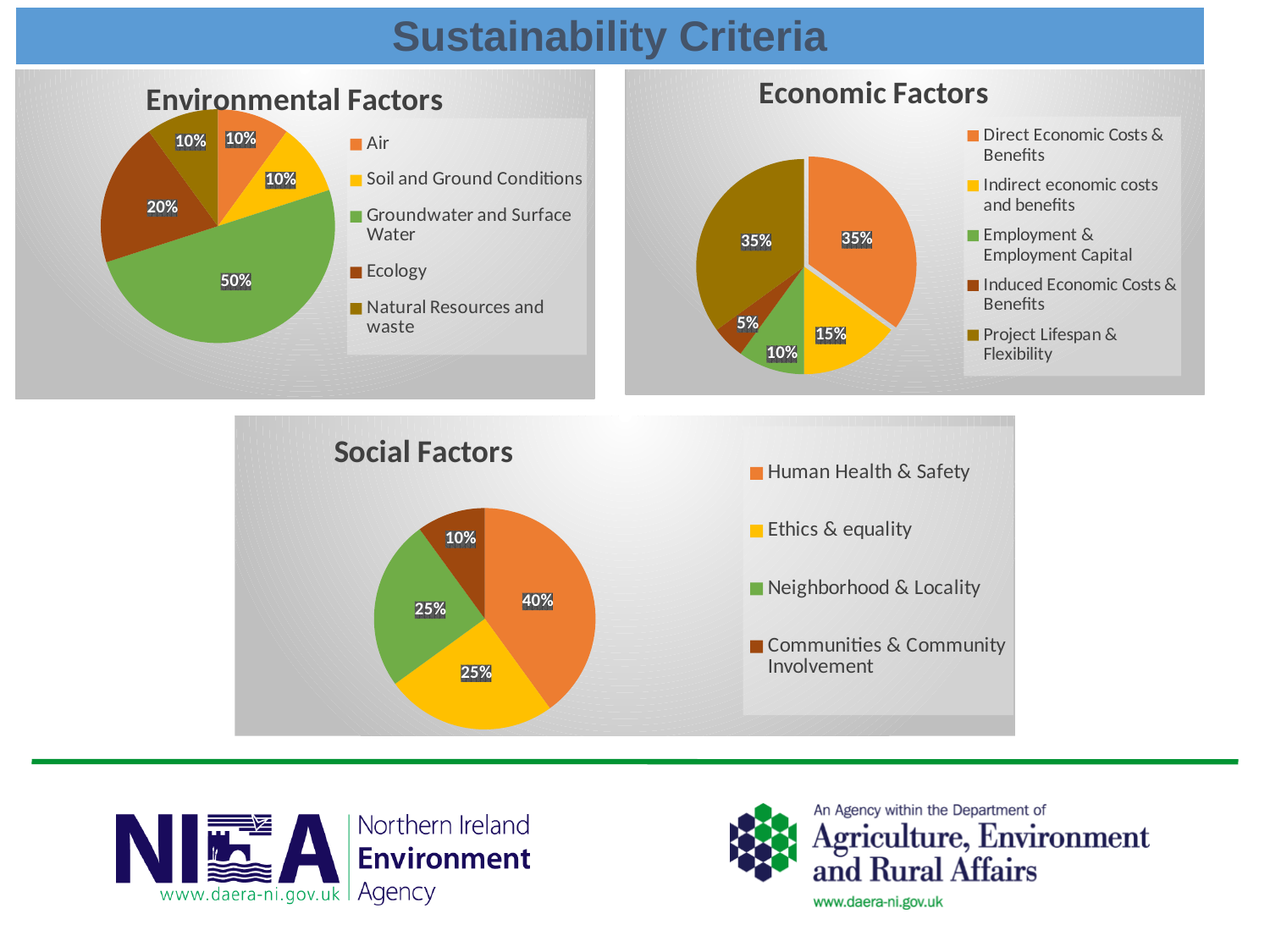
In the Environmental Factors chart, which category has the largest slice? Groundwater and Surface Water In the Economic Factors chart, which is larger: Indirect economic costs and benefits or Employment & Employment Capital? Indirect economic costs and benefits In the Economic Factors chart, which category has the smallest slice? Induced Economic Costs & Benefits In the Social Factors chart, what is the value for Communities & Community Involvement? 10% What type of chart is the Social Factors chart? Pie chart In the Environmental Factors chart, what share does Groundwater and Surface Water have? 50% In the Economic Factors chart, what is the value for Indirect economic costs and benefits? 15% In the Economic Factors chart, what is the difference between Direct Economic Costs & Benefits and Employment & Employment Capital? 25% In the Social Factors chart, how many categories does the legend list? 4 In the Environmental Factors chart, what is the value for Ecology? 20% In the Social Factors chart, what share does Human Health & Safety have? 40% In the Environmental Factors chart, how many categories does the legend list? 5